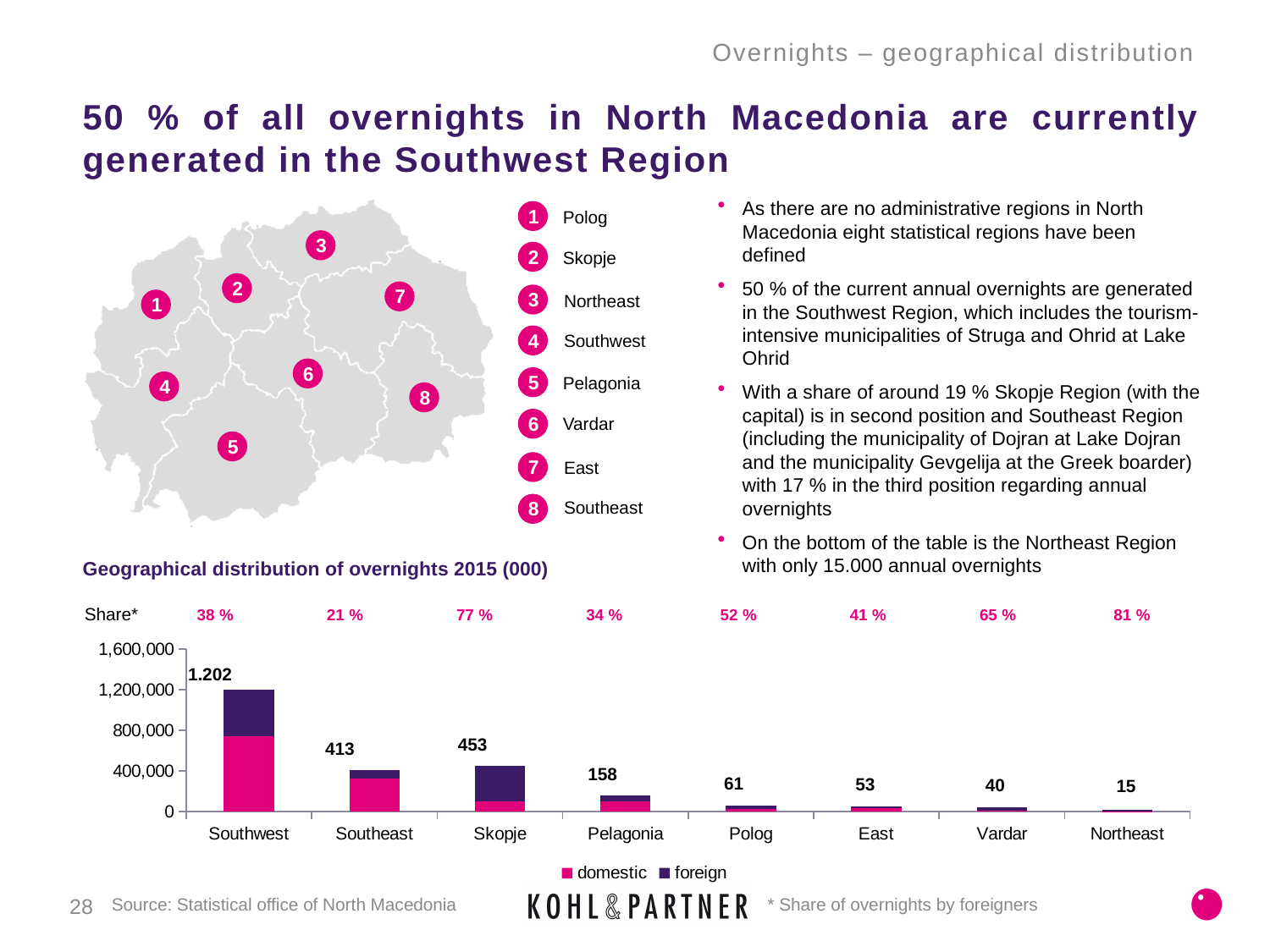
Which region has the highest total overnights in the chart? Southwest What is the total value labelled for Skopje in the chart? 453 What is the total value labelled for Southwest in the chart? 1.202 Which has a larger labelled total, Southeast or Skopje? Skopje Which region has the lowest total overnights in the chart? Northeast What kind of chart is shown on the slide? Stacked bar chart What is the total value labelled for Northeast in the chart? 15 How many regions are shown on the x axis of the chart? 8 What is the difference between the labelled totals for Skopje and Southeast? 40 How many series does the chart legend list? 2 What is the difference between the labelled totals for Pelagonia and Polog? 97 Is the domestic portion of the Southwest bar greater or less than 400,000? greater